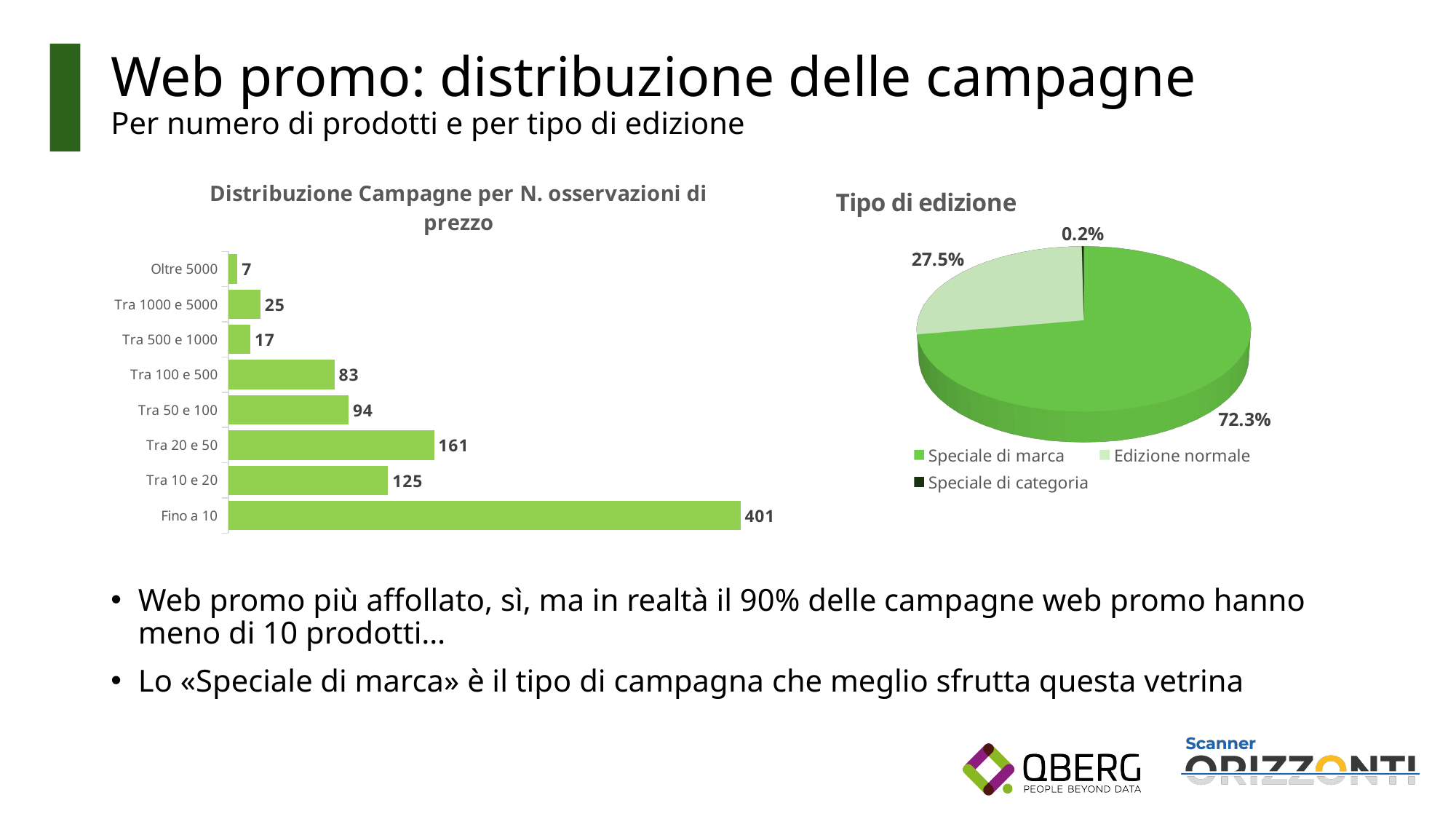
In the pie chart 'Tipo di edizione', which slice is the largest? Speciale di marca In the bar chart 'Distribuzione Campagne per N. osservazioni di prezzo', what is the difference between the values for 'Fino a 10' and 'Tra 10 e 20'? 276 In the bar chart 'Distribuzione Campagne per N. osservazioni di prezzo', which category has the lowest value? Oltre 5000 In the bar chart 'Distribuzione Campagne per N. osservazioni di prezzo', which is larger: 'Tra 100 e 500' or 'Tra 50 e 100'? Tra 50 e 100 What kind of chart is 'Distribuzione Campagne per N. osservazioni di prezzo'? Bar chart In the pie chart 'Tipo di edizione', what share does 'Edizione normale' have? 27.5% What kind of chart is 'Tipo di edizione'? Pie chart How many entries does the legend of the pie chart 'Tipo di edizione' list? 3 In the bar chart 'Distribuzione Campagne per N. osservazioni di prezzo', which category has the highest value? Fino a 10 How many categories does the bar chart 'Distribuzione Campagne per N. osservazioni di prezzo' show? 8 In the bar chart 'Distribuzione Campagne per N. osservazioni di prezzo', what is the value for 'Tra 20 e 50'? 161 In the bar chart 'Distribuzione Campagne per N. osservazioni di prezzo', what is the value for 'Tra 500 e 1000'? 17